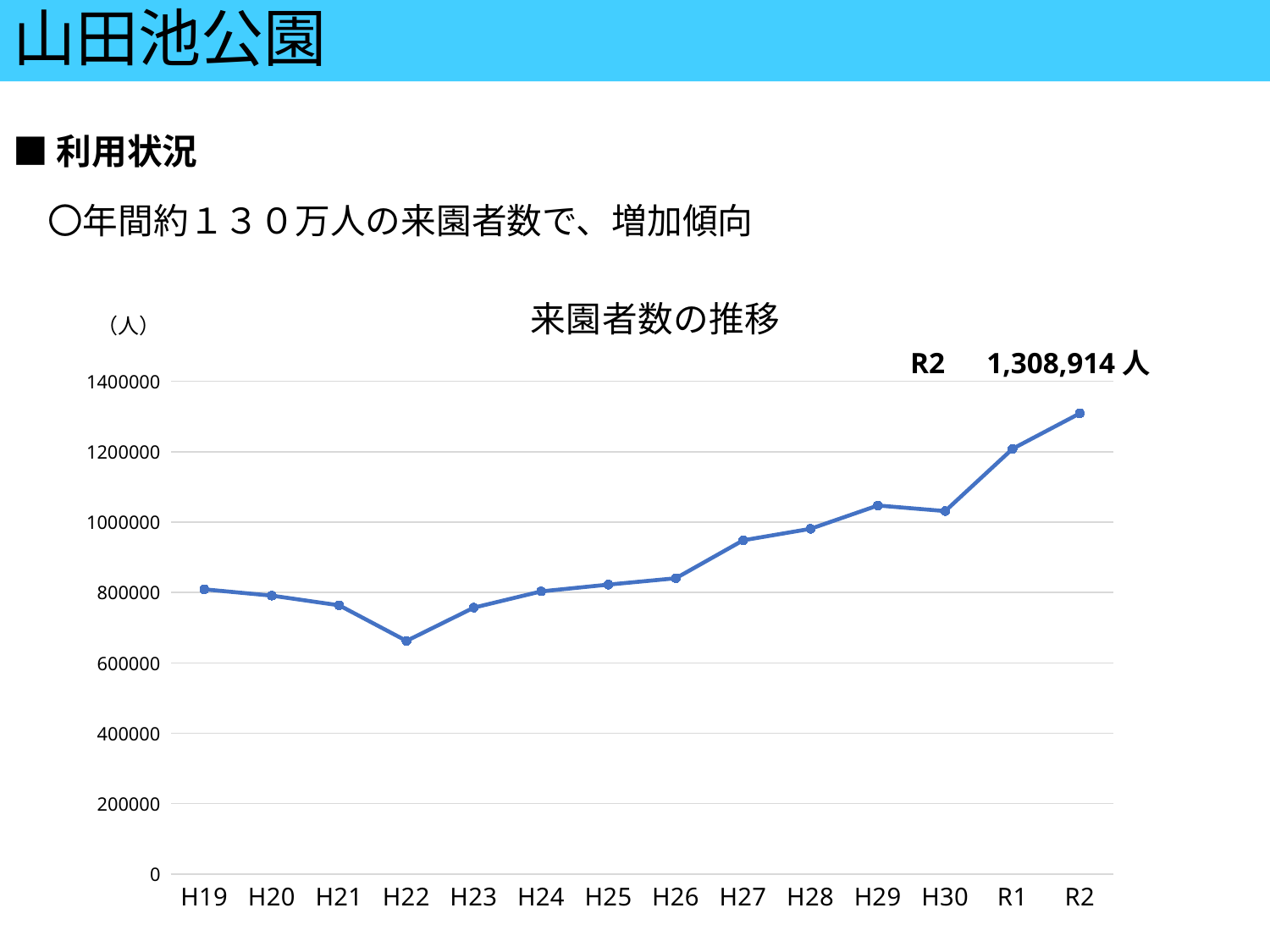
Overall, do the visitor numbers rise or fall from H19 to R2? rise Which year has the highest number of visitors? R2 Which is larger, the value for H19 or the value for H22? H19 How many years (data points) are plotted along the x axis of the chart? 14 Is the value for H22 greater or less than 800000? less What is the title of the chart? 来園者数の推移 Which is larger, the value for R1 or the value for H30? R1 Which year has the lowest number of visitors? H22 What is the number of visitors for R2 according to the label on the chart? 1,308,914人 What kind of chart is shown on the slide? line chart Is the value for R1 greater or less than 1000000? greater Is the value for H27 greater or less than 1000000? less